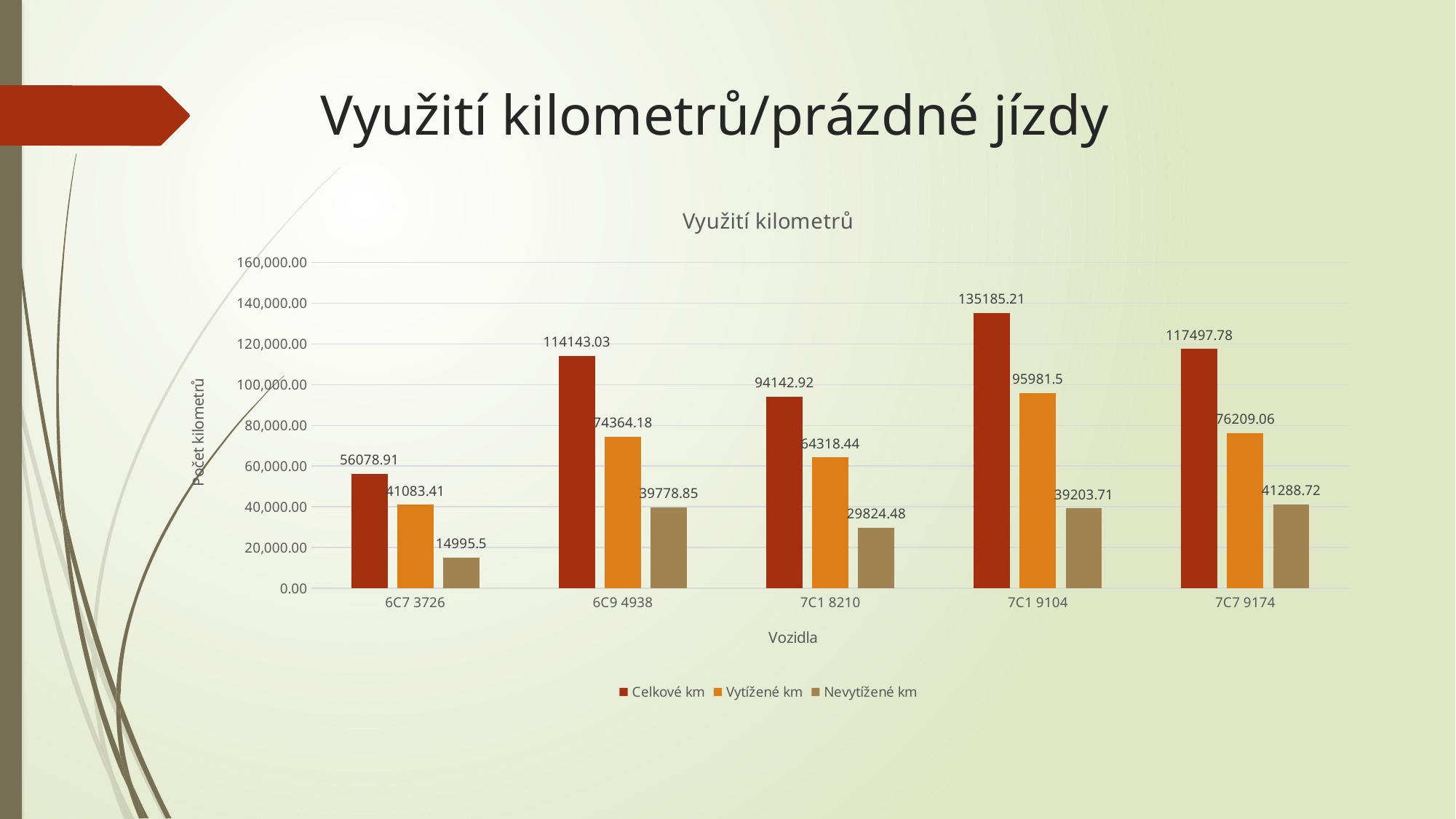
How many vehicles are shown on the x axis? 5 What is the difference between the Celkové km values for 7C1 9104 and 7C7 9174? 17687.43 What is the Nevytížené km value for vehicle 6C7 3726? 14995.5 Which vehicle has the highest Celkové km value? 7C1 9104 What is the Celkové km value for vehicle 7C1 9104? 135185.21 What is the Vytížené km value for vehicle 6C9 4938? 74364.18 How many series does the legend list? 3 What is the Nevytížené km value for vehicle 7C7 9174? 41288.72 What is the title of the chart? Využití kilometrů What kind of chart is shown on the slide? Bar chart Which is larger: the Nevytížené km value for 6C9 4938 or for 7C1 8210? 6C9 4938 Which vehicle has the lowest Vytížené km value? 6C7 3726